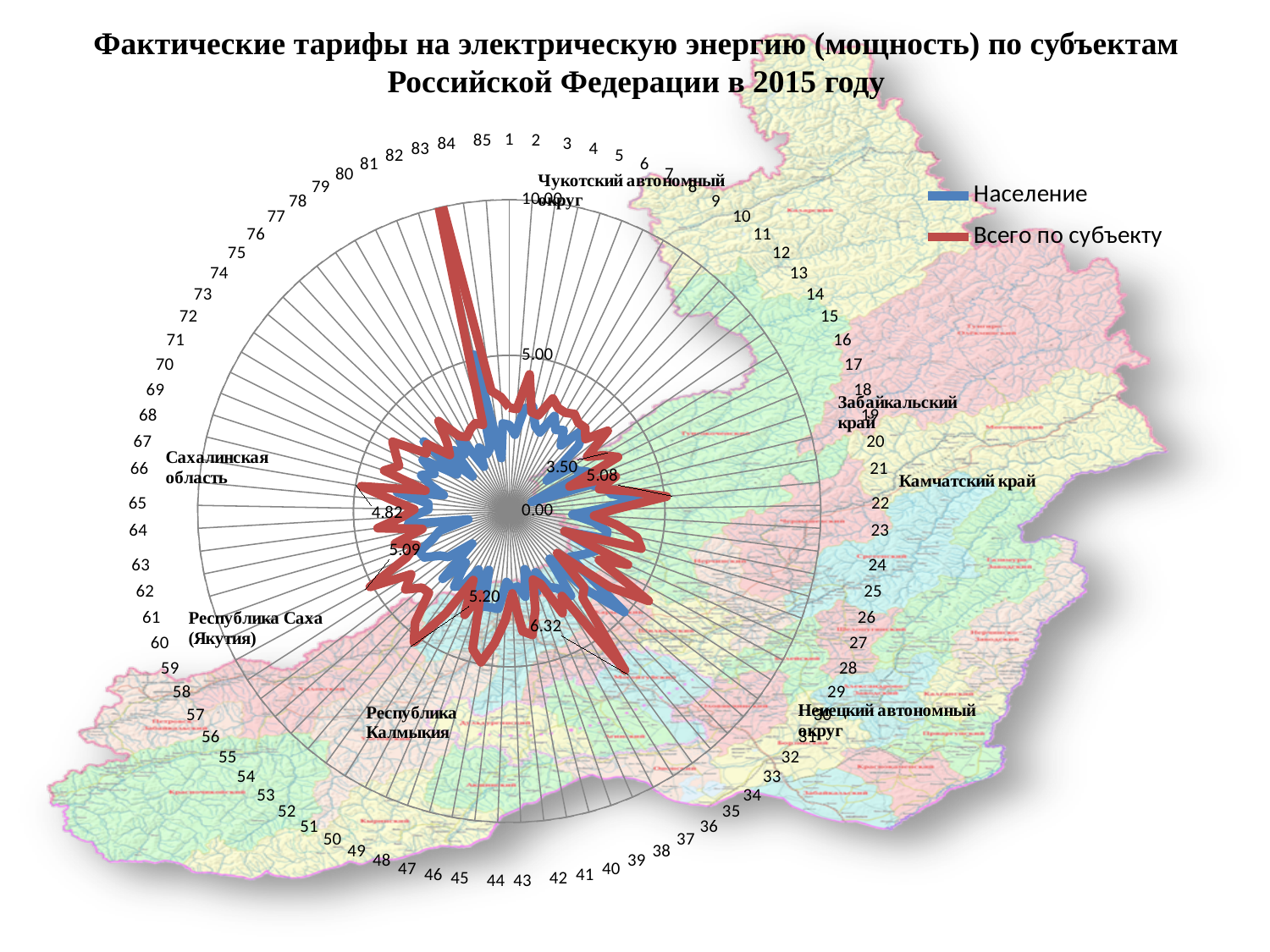
What kind of chart is shown on the slide? Radar chart What value is labelled for Сахалинская область? 4.82 How many series does the legend list? 2 Which colour represents the series 'Всего по субъекту'? Red Which region has the highest tariff value on the chart? Чукотский автономный округ What are the two series named in the legend? Население; Всего по субъекту How many numbered categories are arranged around the radar chart? 85 Which labelled value is larger: Ненецкий автономный округ or Сахалинская область? Ненецкий автономный округ What is the highest value shown on the radial axis? 10.00 What value is labelled for Республика Калмыкия? 5.20 What value is labelled for Ненецкий автономный округ? 6.32 Is the value for Чукотский автономный округ greater or less than 5.00? greater